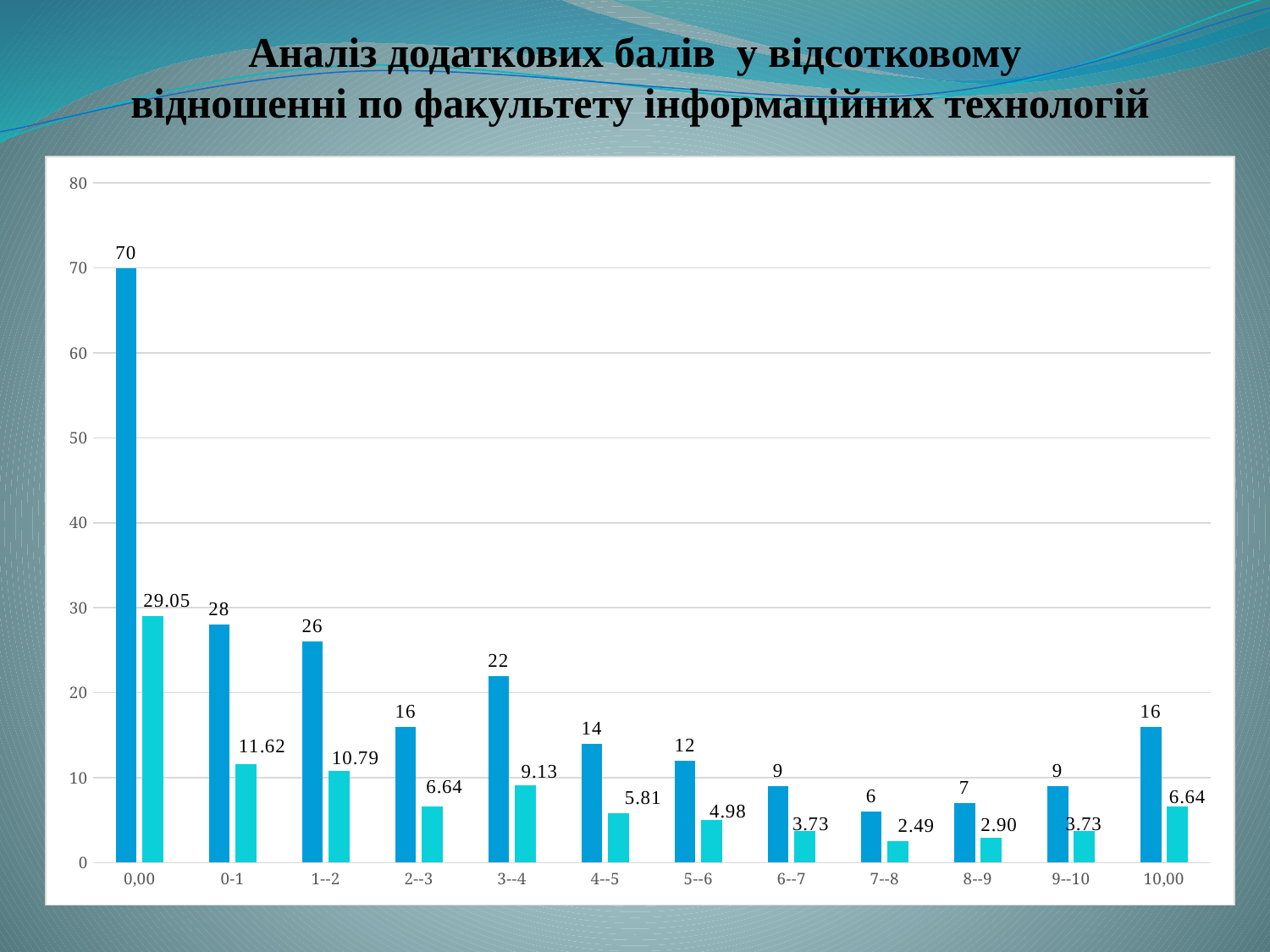
Is the dark blue value for 10,00 greater or less than 20? less What is the difference between the dark blue values for 0-1 and 1--2? 2 What kind of chart is shown on the slide? bar chart How many categories are shown on the x axis? 12 What is the difference between the light cyan values for 2--3 and 10,00? 0 Which category has the lowest light cyan bar? 7--8 What is the value of the dark blue bar for the category 7--8? 6 What is the value of the light cyan bar for the category 0,00? 29.05 What is the value of the light cyan bar for the category 3--4? 9.13 Which is larger: the dark blue value for 3--4 or the dark blue value for 4--5? 3--4 What is the value of the dark blue bar for the category 0,00? 70 Which category has the highest dark blue bar? 0,00